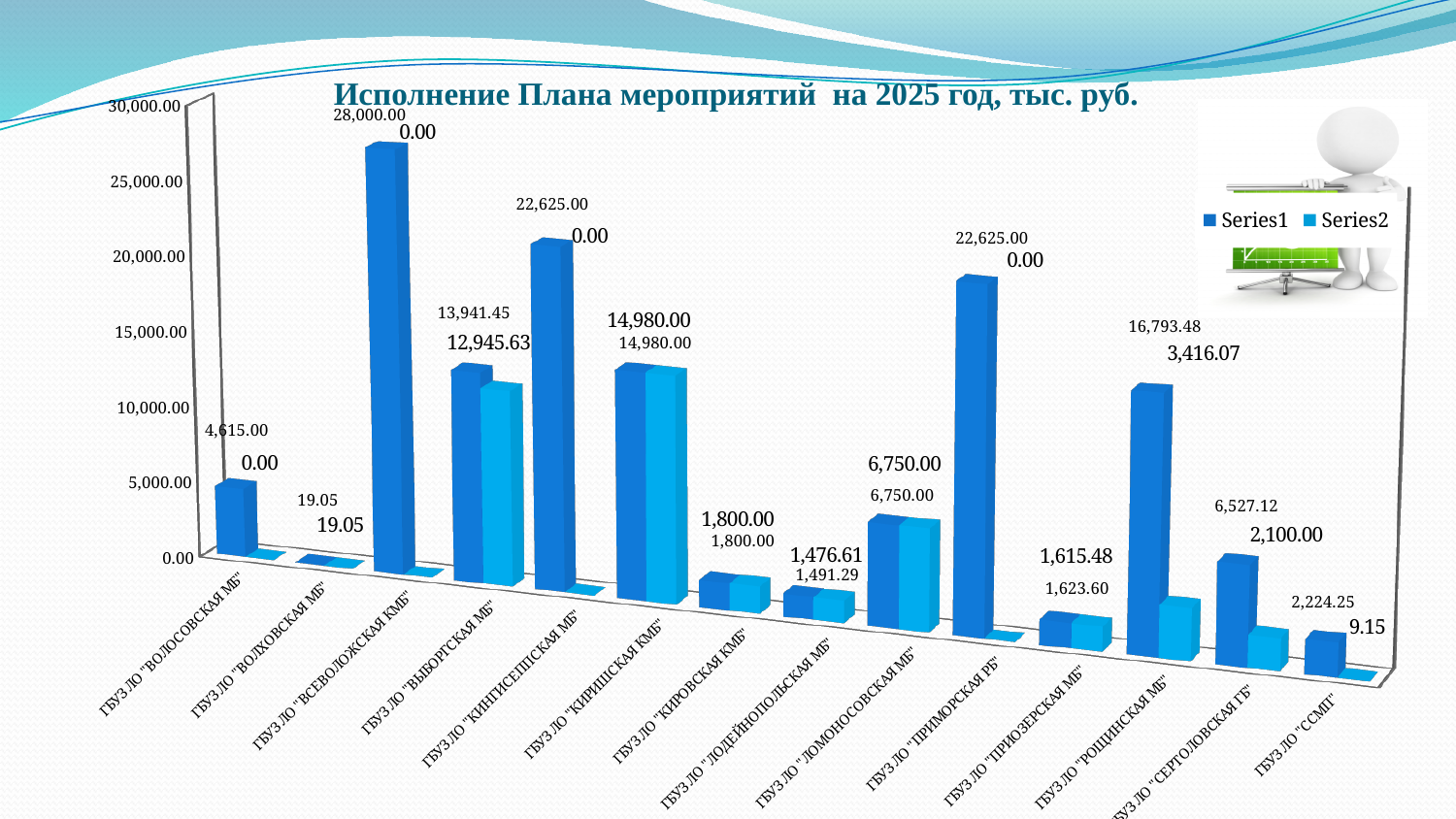
What is the Series2 value for ГБУЗ ЛО "РОЩИНСКАЯ МБ"? 3,416.07 How many series does the legend list? 2 What is the difference between the Series1 and Series2 values for ГБУЗ ЛО "РОЩИНСКАЯ МБ"? 13,377.41 Which category has the highest Series1 value? ГБУЗ ЛО "ВСЕВОЛОЖСКАЯ КМБ" How many categories (organisations) are shown on the x axis? 14 What is the Series1 value for ГБУЗ ЛО "ССМП"? 2,224.25 What is the Series1 value for ГБУЗ ЛО "ВСЕВОЛОЖСКАЯ КМБ"? 28,000.00 Which category has the lowest Series1 value? ГБУЗ ЛО "ВОЛХОВСКАЯ МБ" What is the title of the chart? Исполнение Плана мероприятий на 2025 год, тыс. руб. Which has the larger Series1 value: ГБУЗ ЛО "ВЫБОРГСКАЯ МБ" or ГБУЗ ЛО "КИНГИСЕППСКАЯ МБ"? ГБУЗ ЛО "КИНГИСЕППСКАЯ МБ" What kind of chart is shown on the slide? bar chart What is the Series2 value for ГБУЗ ЛО "ВЫБОРГСКАЯ МБ"? 12,945.63